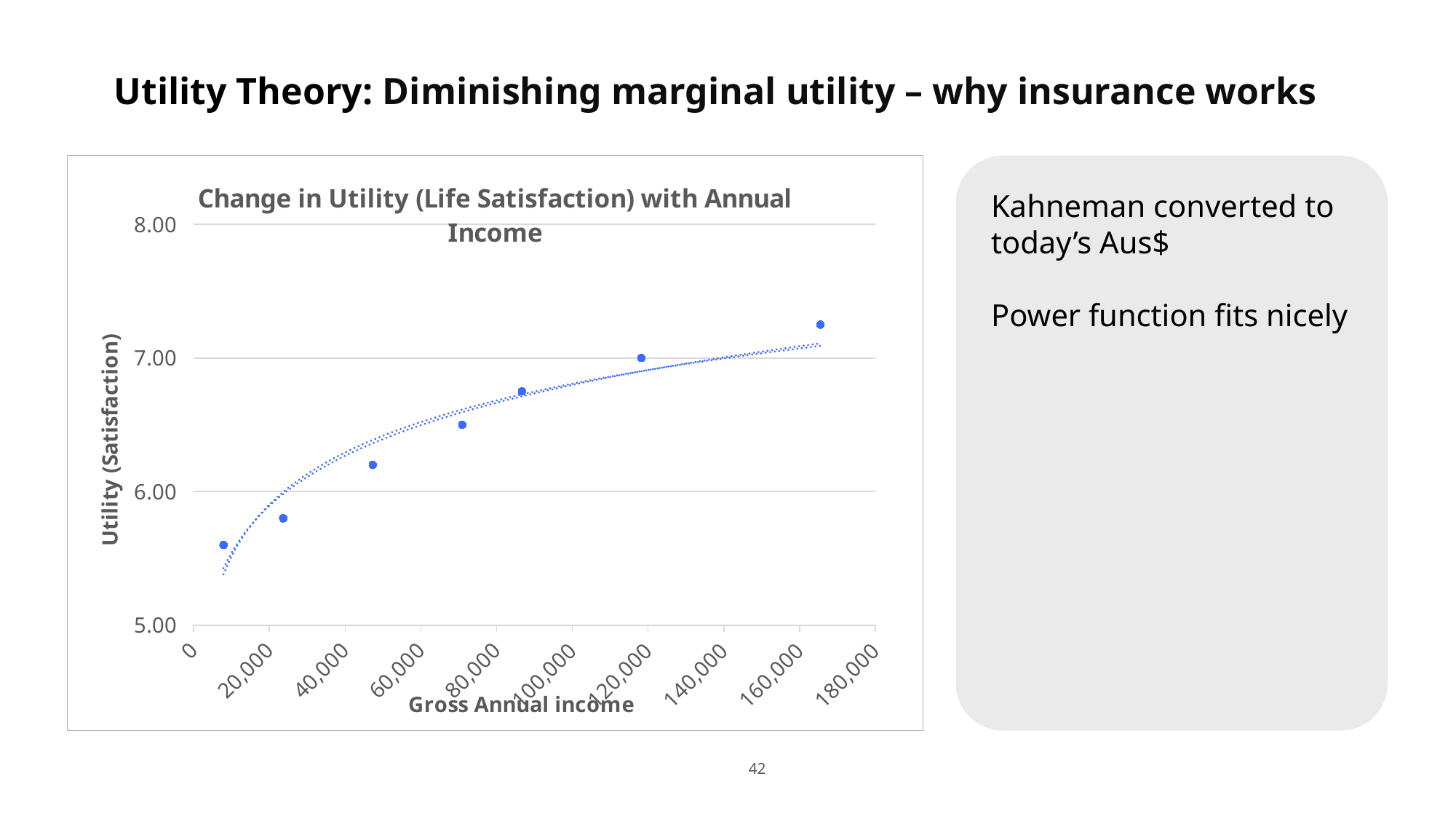
What is the label of the vertical axis of the chart? Utility (Satisfaction) Which data point has the higher utility: the one near 24,000 income or the one near 120,000 income? The one near 120,000 income What kind of chart is shown on the slide? Scatter chart Is the utility value for the data point near 88,000 income greater or less than 7.00? less Is the utility value for the lowest-income data point greater or less than 6.00? less Is the utility value for the data point near 72,000 income greater or less than 7.00? less How many data points are plotted in the chart? 7 Does utility rise or fall as gross annual income increases along the x axis? Rises What is the title of the chart? Change in Utility (Life Satisfaction) with Annual Income